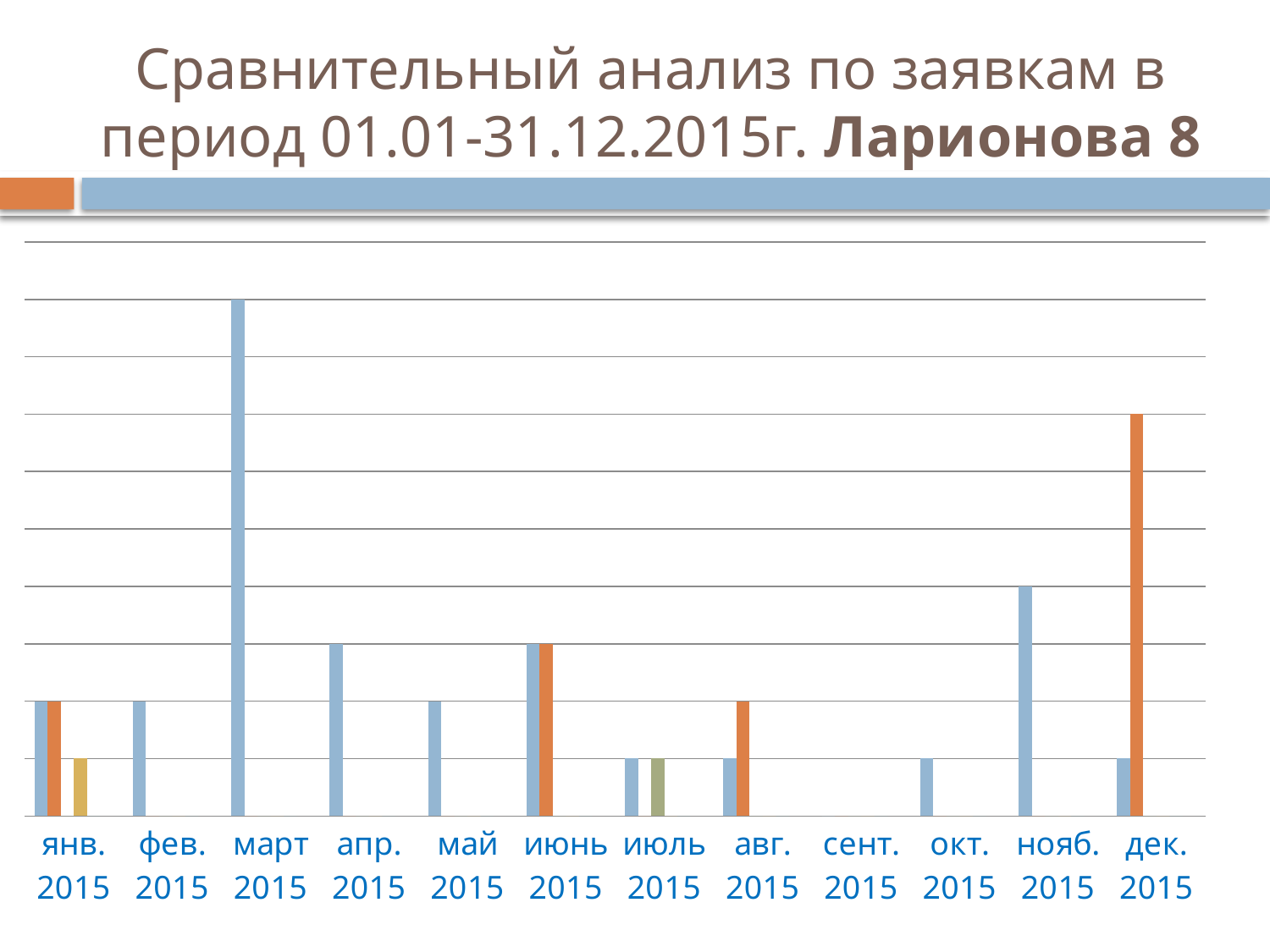
Which has the taller orange bar, авг. 2015 or дек. 2015? дек. 2015 Which month has the tallest orange bar? дек. 2015 How many months have an orange bar? 4 Which month has a yellow bar? янв. 2015 Which has the taller blue bar, март 2015 or нояб. 2015? март 2015 Which month has the tallest bar in the chart? март 2015 What address is named in bold in the slide title? Ларионова 8 Do the blue bars rise or fall from март 2015 to май 2015? fall Which has the taller blue bar, апр. 2015 or май 2015? апр. 2015 Which month has no bars at all? сент. 2015 How many months are shown along the x axis of the chart? 12 What kind of chart is shown on the slide? bar chart